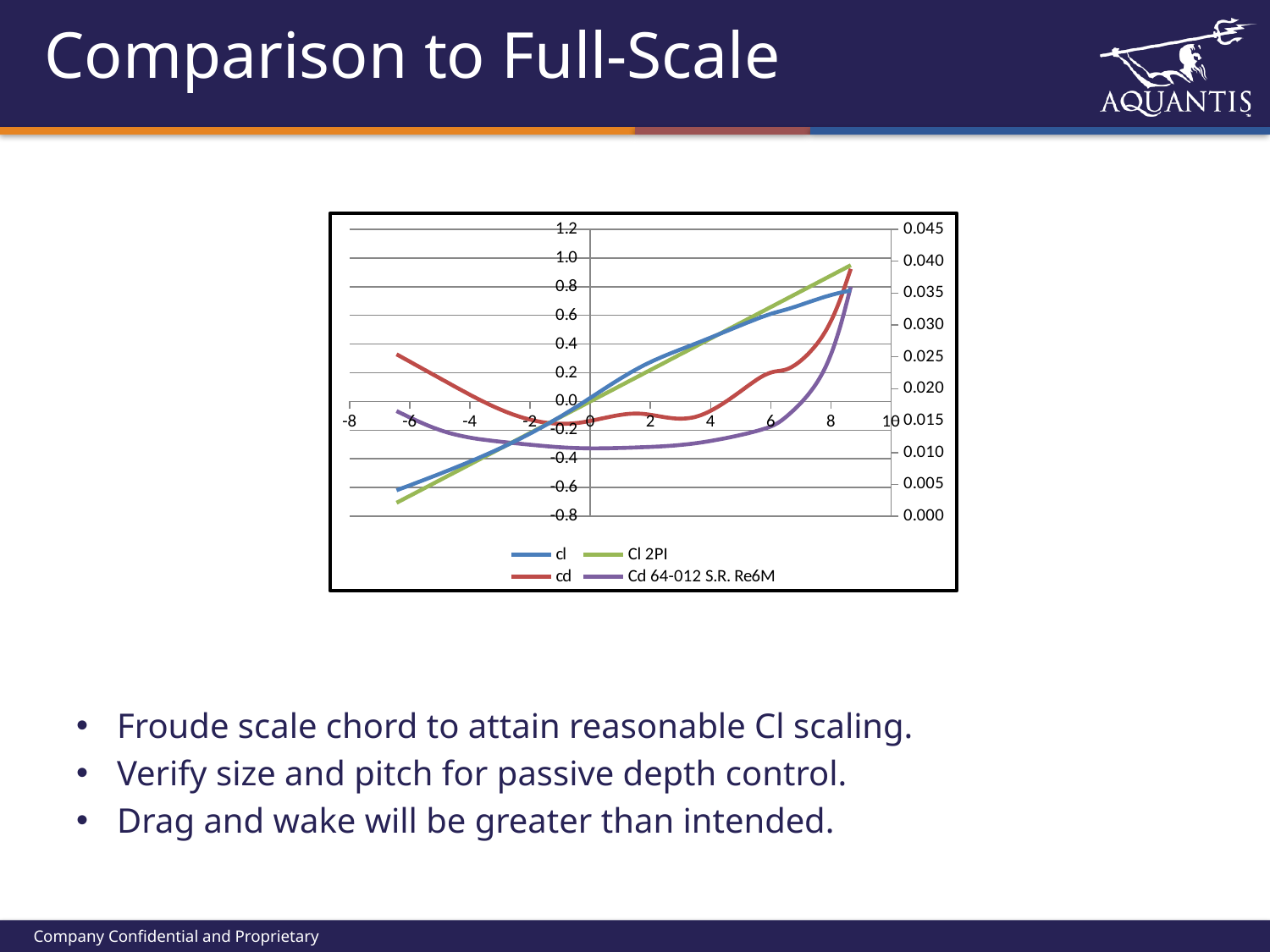
At x = 8, which series has the higher value, cl or Cl 2PI? Cl 2PI What are the four series named in the chart's legend? cl, Cl 2PI, cd, Cd 64-012 S.R. Re6M Does the cl series rise or fall as the x-axis value increases? rises Is the value of the Cl 2PI series at x = -6 greater or less than -0.4 on the left axis? less What kind of chart is shown on the slide? line chart How many series does the chart's legend list? 4 Is the value of the cd series at x = -6 greater or less than 0.020 on the right axis? greater What is the lowest tick value shown on the chart's left-hand vertical axis? -0.8 Is the value of the cl series at x = 8 greater or less than 0.6 on the left axis? greater What is the highest tick value shown on the chart's right-hand vertical axis? 0.045 Does the Cl 2PI series rise or fall as the x-axis value increases? rises